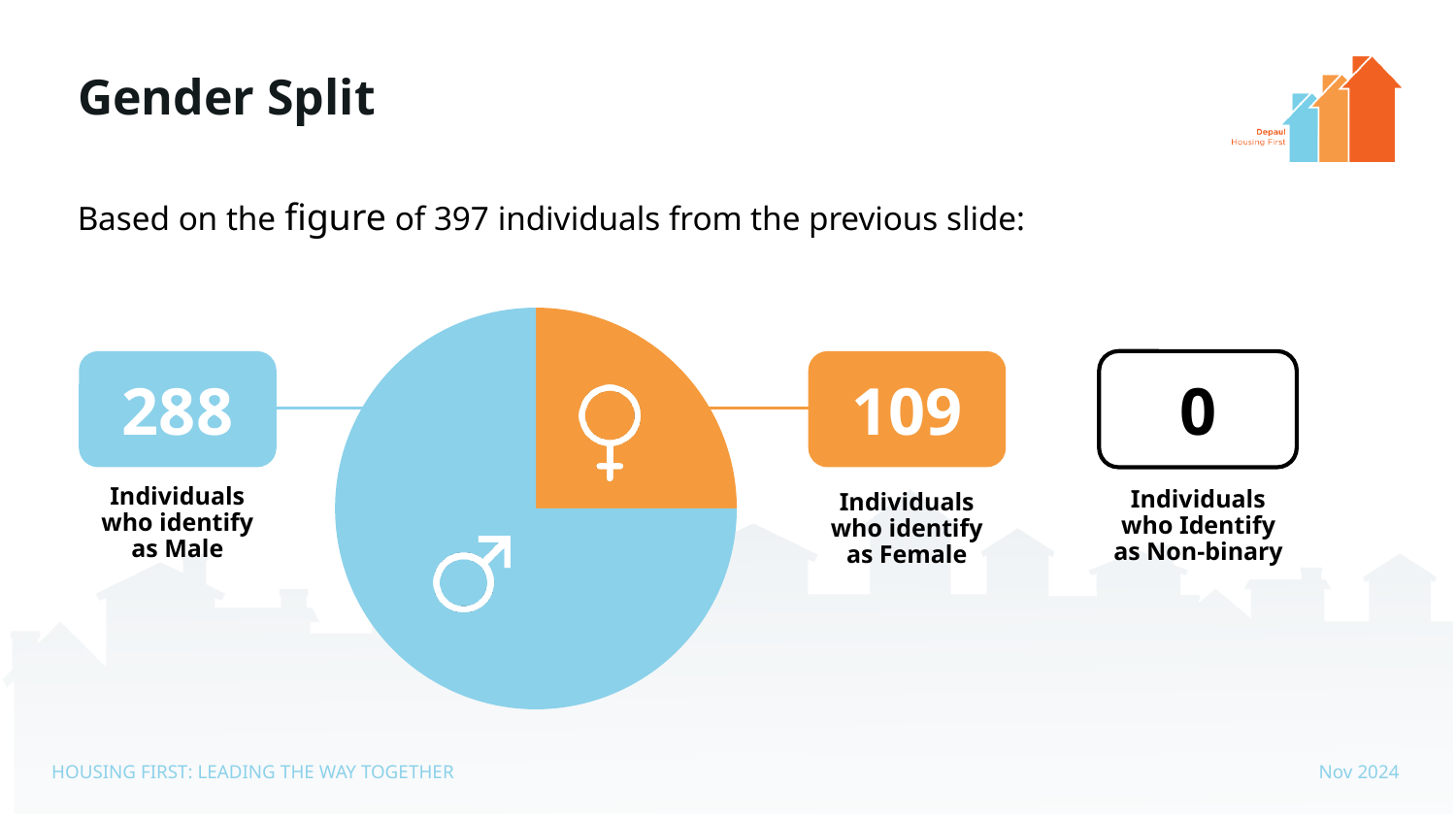
How many gender categories are shown on the slide? 3 Which is larger, the number of individuals who identify as Female or as Male? Male What is the title of the slide containing the pie chart? Gender Split What type of chart is shown on the slide? pie chart Which colour represents individuals who identify as Female in the pie chart? orange How many individuals identify as Non-binary? 0 What is the difference between the number of individuals who identify as Male and those who identify as Female? 179 What is the total number of individuals the gender split is based on? 397 Which gender category has the lowest number of individuals? Non-binary Which gender category has the highest number of individuals? Male How many individuals identify as Female? 109 How many individuals identify as Male? 288